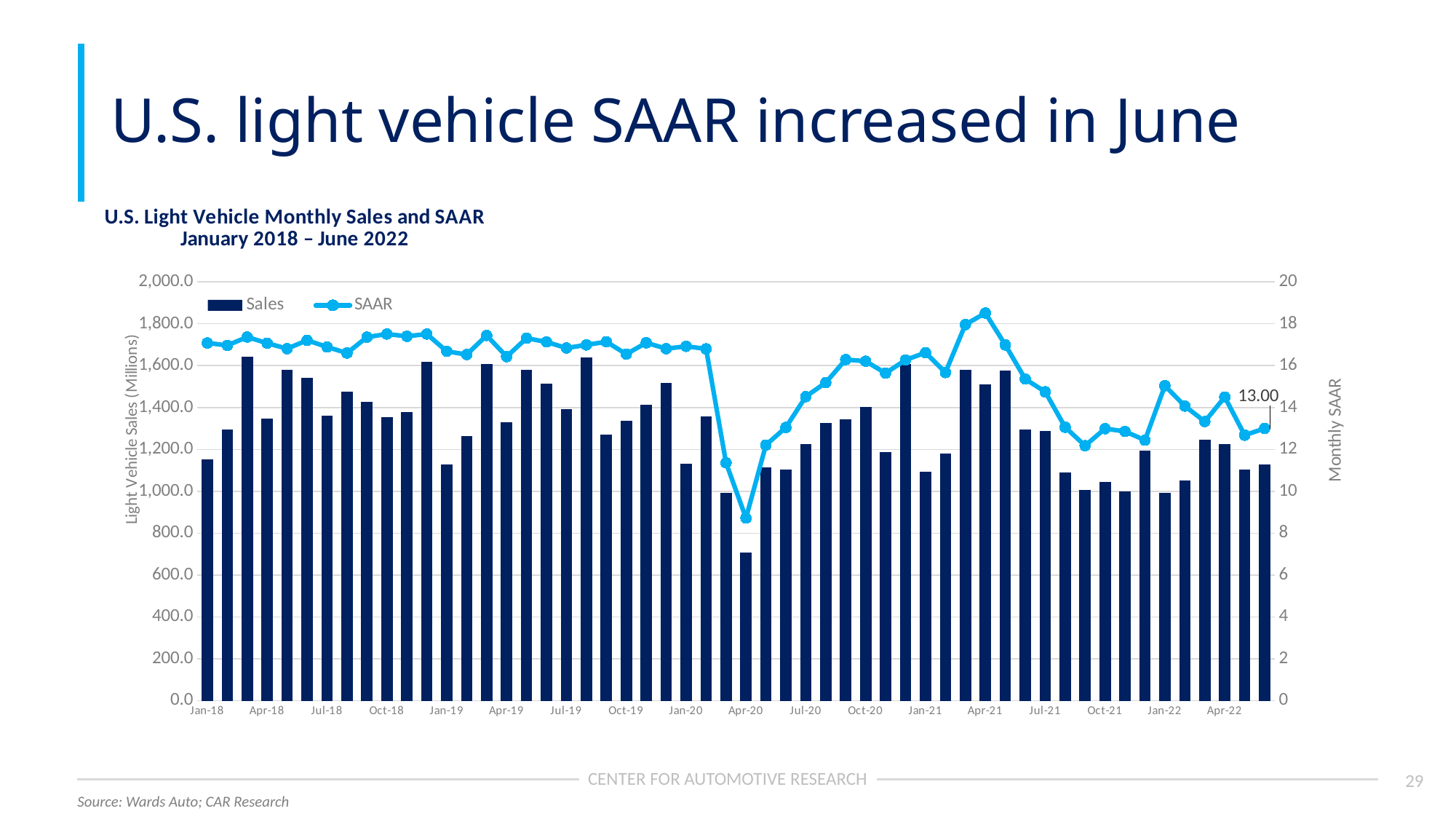
What kind of chart is this? Combination bar and line chart Is the SAAR value for Apr-21 greater or less than 18? greater How many month labels are shown on the x axis? 18 At which x-axis month does the SAAR line reach its highest point? Apr-21 Which has the larger Sales value, Jan-18 or Apr-18? Apr-18 Is the Sales value for Jan-18 greater or less than 1,200? less Does the SAAR line rise or fall between Jan-20 and Apr-20? fall What SAAR value is shown by the data label at the end of the SAAR line (June 2022)? 13.00 What is the title of the right-hand vertical axis? Monthly SAAR How many series does the legend list? 2 Is the Sales value for Apr-20 greater or less than 800? less At which x-axis month does the SAAR line reach its lowest point? Apr-20